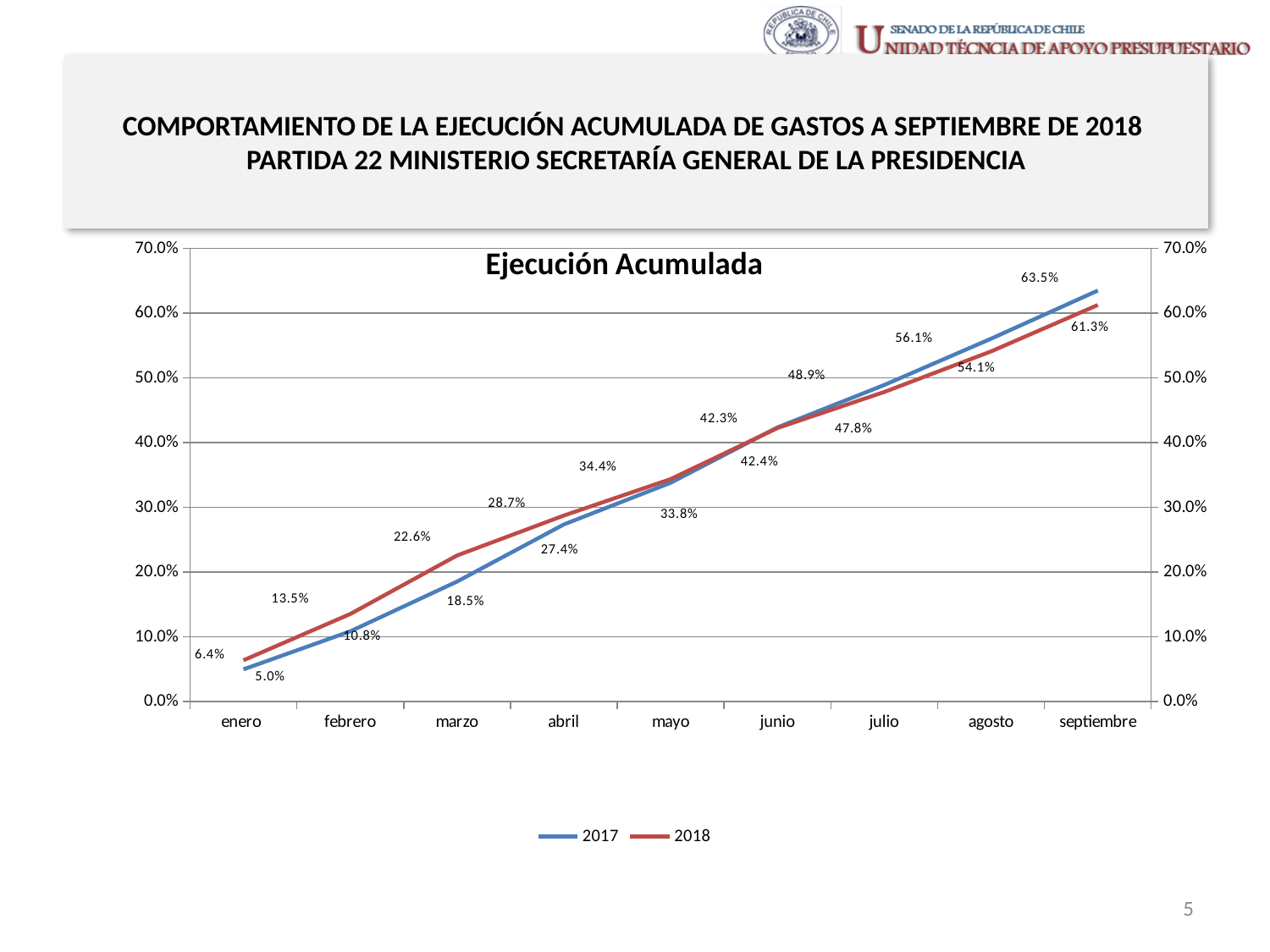
Is the value for 2017 in abril greater or less than 30.0%? less How many months are plotted along the x axis? 9 What is the value for 2017 in septiembre? 63.5% In agosto, which series has the higher value, 2017 or 2018? 2017 What is the value for 2018 in enero? 6.4% What is the value for 2018 in septiembre? 61.3% What is the title of the chart? Ejecución Acumulada What kind of chart is shown on the slide? line chart What is the difference between the 2018 and 2017 values in marzo? 4.1 percentage points What is the value for 2017 in marzo? 18.5% How many series does the legend list? 2 Do the values for 2018 rise or fall from enero to septiembre? rise